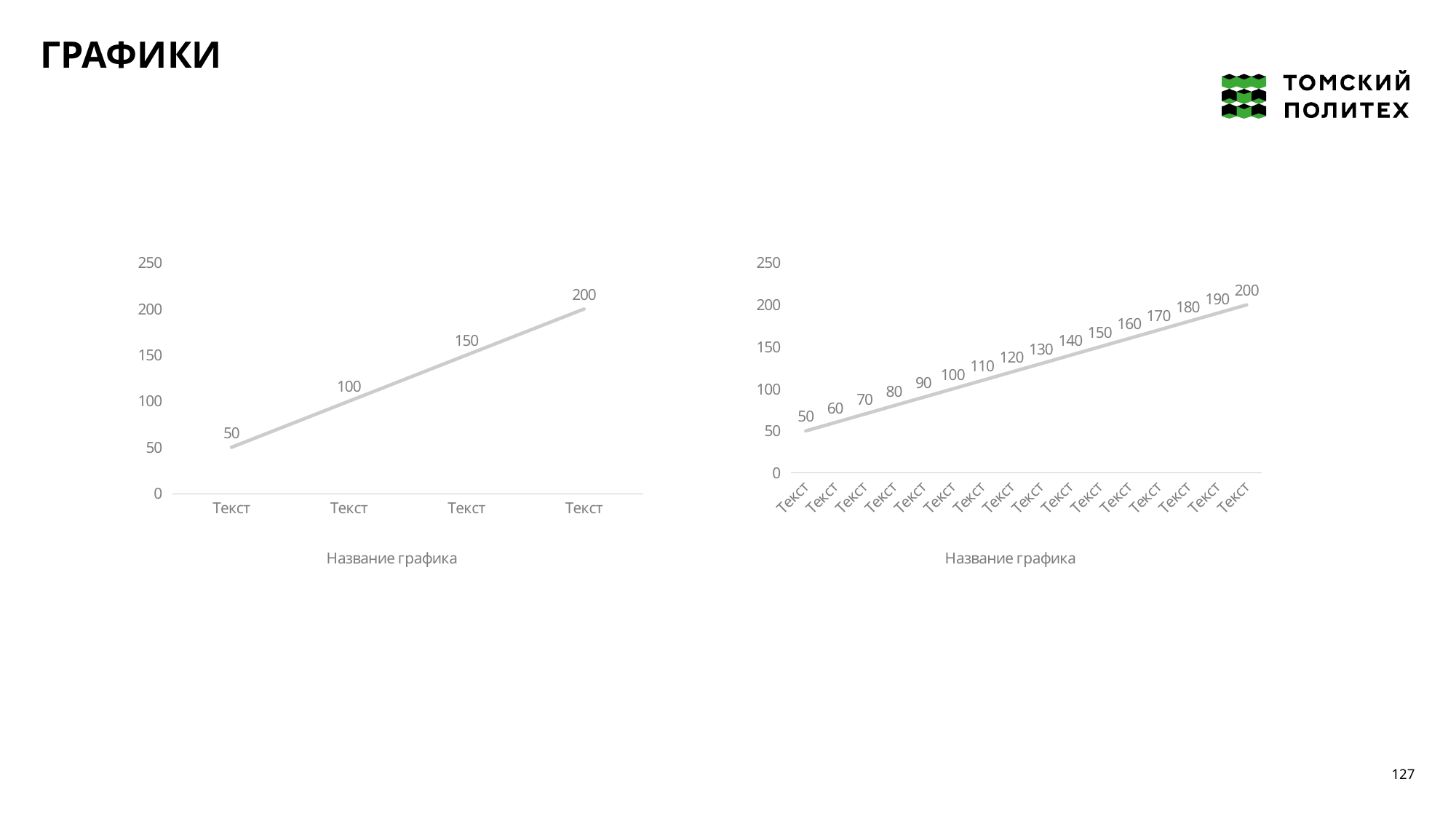
In the chart on the left, do the values rise or fall from left to right? rise In the chart on the right, what is the lowest value plotted? 50 In the chart on the left, how many data points are plotted? 4 In the chart on the left, what is the value of the last data point? 200 What kind of chart is the chart on the right of the slide? line chart In the chart on the right, how many data points are plotted? 16 What is the title shown below the chart on the left? Название графика In the chart on the left, what is the value of the first data point? 50 In the chart on the right, what is the highest value plotted? 200 What kind of chart is the chart on the left of the slide? line chart In the chart on the right, what is the value of the second data point? 60 In the chart on the left, what is the difference between the last and the first data point? 150